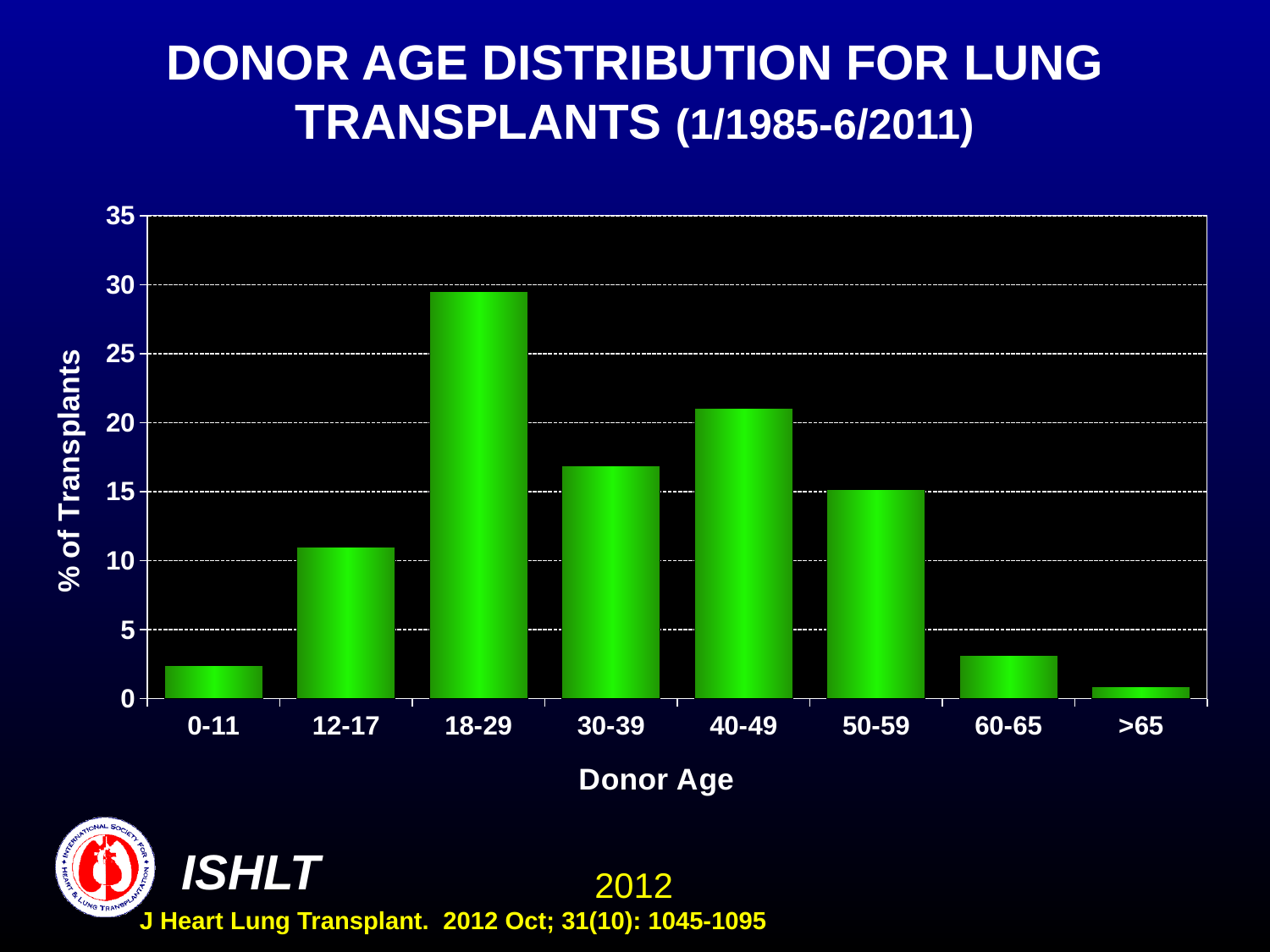
Is the value for the 0-11 donor age group greater or less than 5? less What is the label of the y axis? % of Transplants Which has a higher percentage of transplants, the 40-49 or the 30-39 donor age group? 40-49 Is the value for the 30-39 donor age group greater or less than 20? less Is the value for the 18-29 donor age group greater or less than 25? greater What kind of chart is shown on the slide? bar chart Which donor age group has the highest percentage of transplants? 18-29 Which donor age group has the lowest percentage of transplants? >65 Which has a higher percentage of transplants, the 12-17 or the 0-11 donor age group? 12-17 How many donor age categories are shown on the x axis? 8